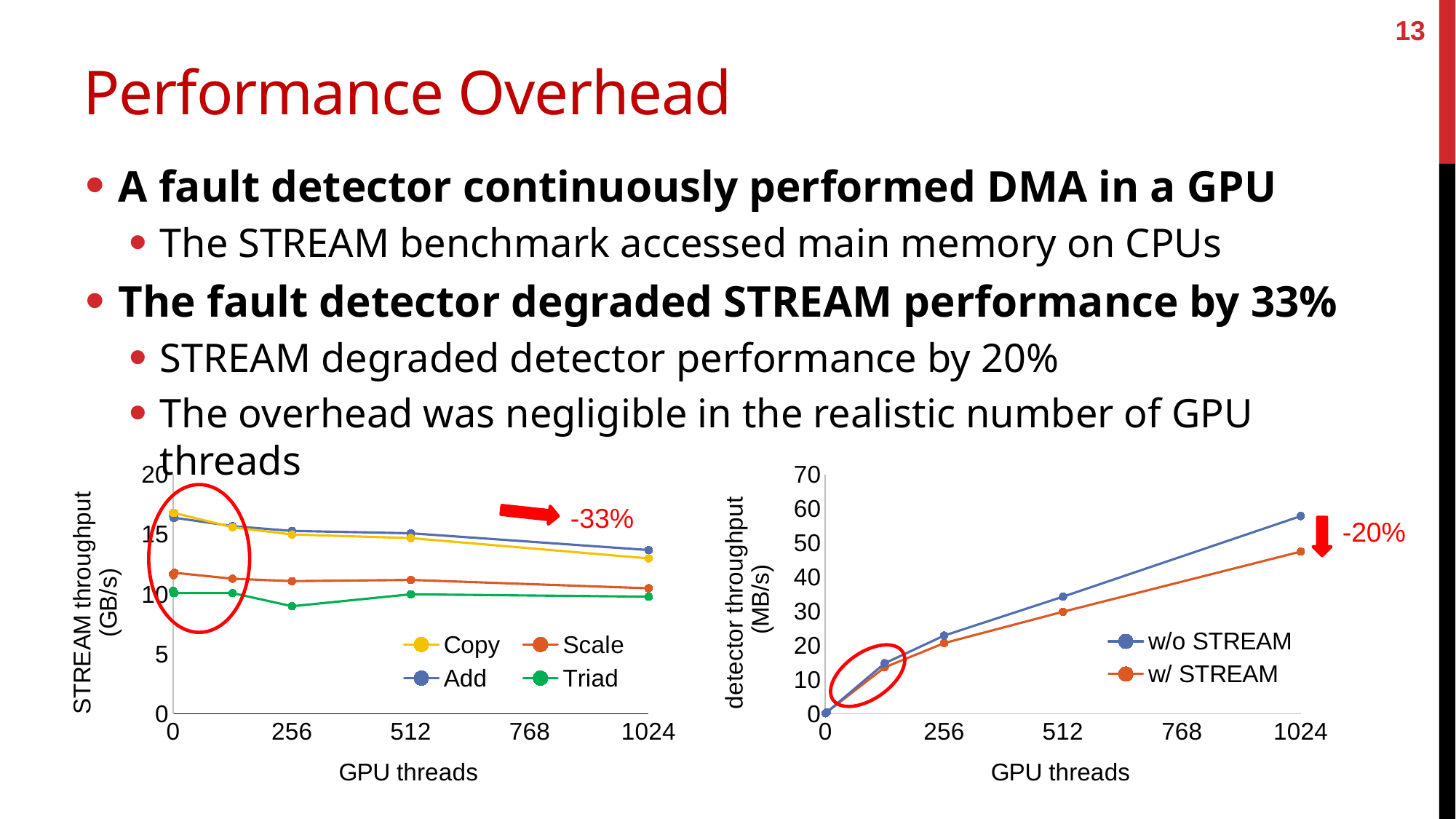
In the right chart (detector throughput), is the w/o STREAM value at 512 GPU threads greater or less than 30? greater In the left chart (STREAM throughput), is the Add value at 1024 GPU threads greater or less than 15? less How many series does the legend of the right chart (detector throughput) list? 2 In the left chart (STREAM throughput), is the Copy value at 0 GPU threads greater or less than 15? greater In the right chart (detector throughput), which series is higher at 1024 GPU threads, w/o STREAM or w/ STREAM? w/o STREAM In the right chart (detector throughput), does the w/o STREAM series rise or fall as GPU threads increase? rise What kind of chart is the left chart (STREAM throughput)? line chart What percentage annotation is shown next to the red arrow on the right chart (detector throughput)? -20% In the left chart (STREAM throughput), does the Copy series rise or fall as GPU threads increase? fall In the left chart (STREAM throughput), which series is higher at 0 GPU threads, Copy or Triad? Copy How many series does the legend of the left chart (STREAM throughput) list? 4